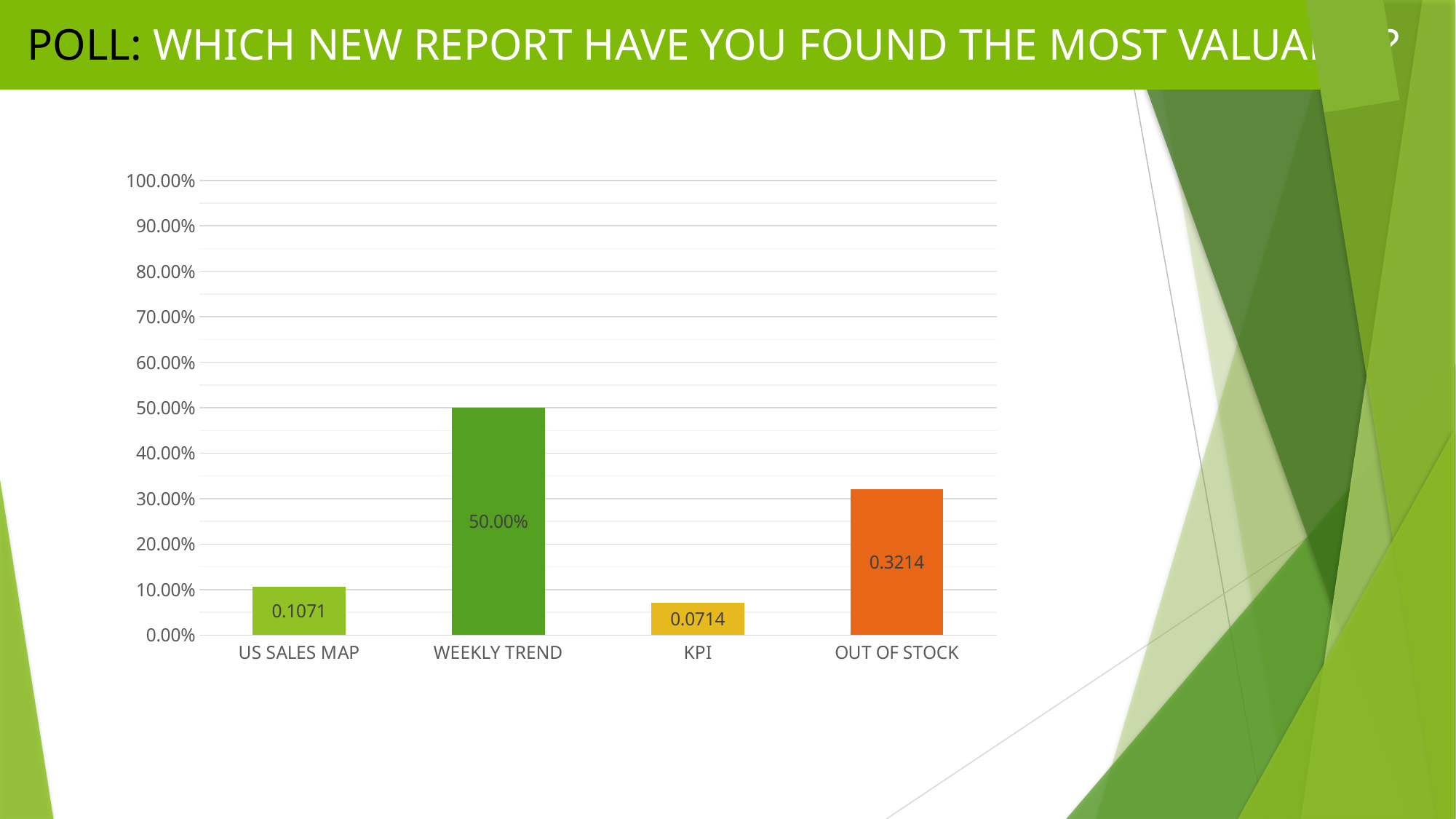
Which is larger, the value for OUT OF STOCK or the value for US SALES MAP? OUT OF STOCK Is the value for KPI greater or less than 10.00%? less What is the data label shown on the KPI bar? 0.0714 Which report has the highest value in the chart? WEEKLY TREND What is the data label shown on the US SALES MAP bar? 0.1071 What is the data label shown on the OUT OF STOCK bar? 0.3214 Which report has the lowest value in the chart? KPI How many report categories are shown on the x axis? 4 What is the data label shown on the WEEKLY TREND bar? 50.00% Is the value for WEEKLY TREND greater or less than 40.00%? greater What kind of chart is shown on the slide? Bar chart What is the difference between the OUT OF STOCK value and the US SALES MAP value, using the labels as printed? 0.2143